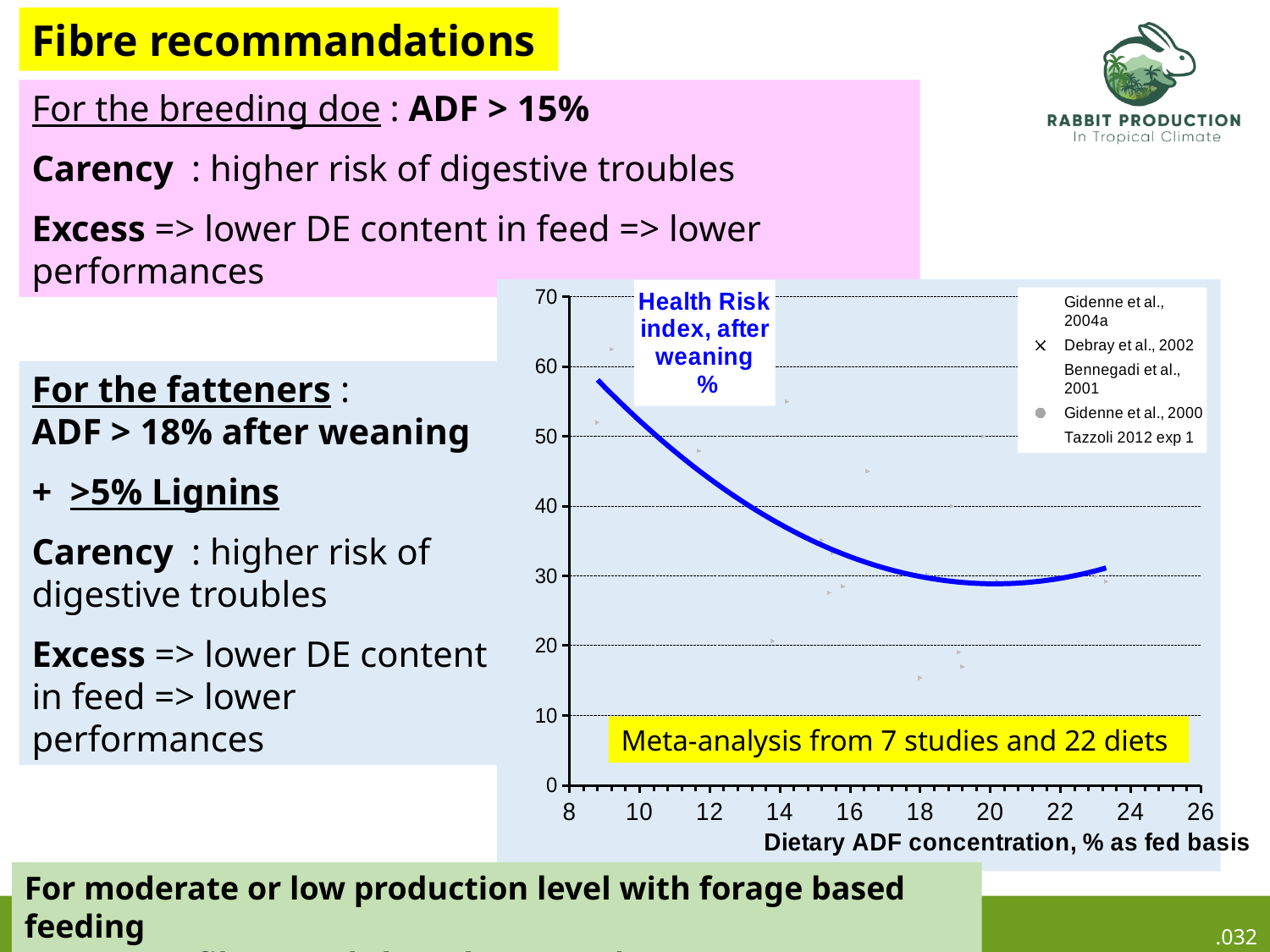
How many series does the chart legend list? 5 Does the fitted curve rise or fall as dietary ADF concentration increases from 10 to 18? fall What quantity is plotted on the y axis of the chart? Health Risk index, after weaning % What kind of chart is shown on the slide? scatter chart What is the highest value shown on the x axis of the chart? 26 Is the fitted curve's value at a dietary ADF concentration of 12 greater or less than 40? greater What is the title of the x axis of the chart? Dietary ADF concentration, % as fed basis Is the fitted curve's value at a dietary ADF concentration of 9 greater or less than 50? greater Is the fitted curve's value at a dietary ADF concentration of 14 greater or less than 40? less